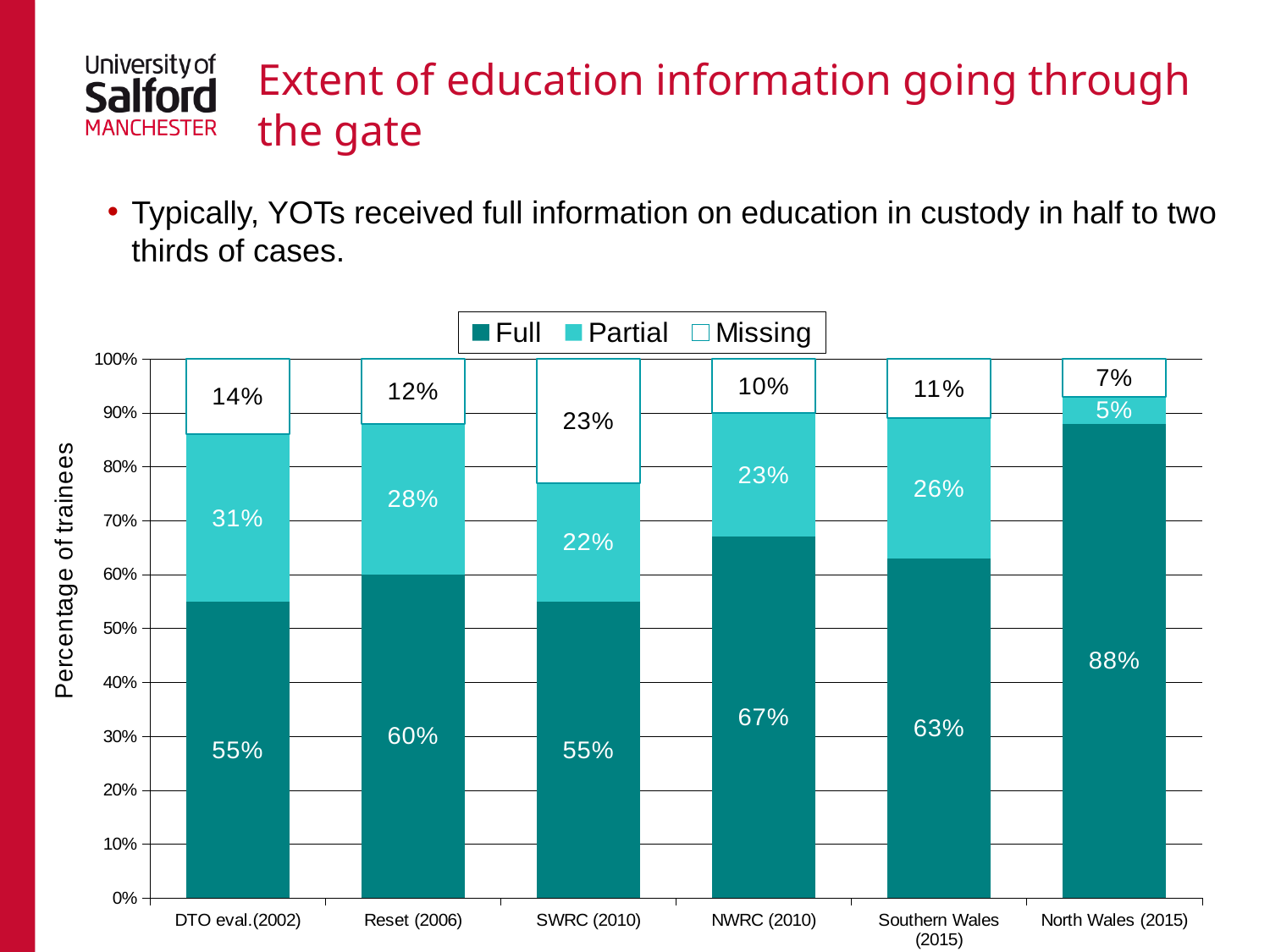
What is the label on the y axis? Percentage of trainees What kind of chart is shown? Stacked bar chart What is the Full value for NWRC (2010)? 67% What is the difference between the Full values for Reset (2006) and DTO eval.(2002)? 5% How many series does the legend list? 3 Which is larger, the Missing value for DTO eval.(2002) or the Missing value for Reset (2006)? DTO eval.(2002) What is the Missing value for SWRC (2010)? 23% How many categories are shown on the x axis? 6 Which category has the highest Full value? North Wales (2015) What is the Partial value for Southern Wales (2015)? 26% Which category has the lowest Partial value? North Wales (2015) What is the total of the Full and Partial segments for NWRC (2010)? 90%